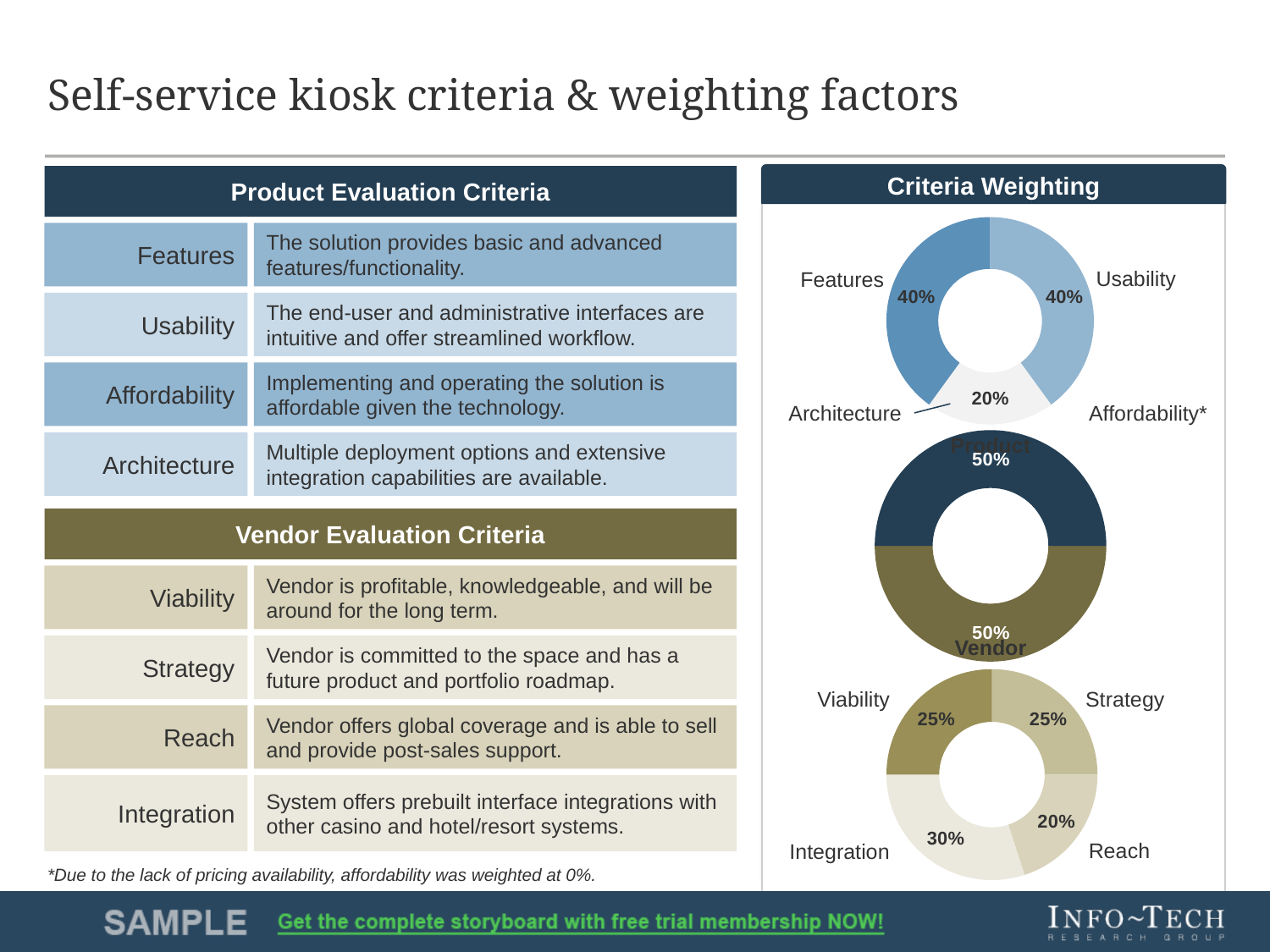
In the bottom donut chart under Criteria Weighting, which criterion has the highest weighting? Integration In the middle donut chart under Criteria Weighting, how many segments are shown? 2 In the bottom donut chart under Criteria Weighting, what is the weighting for Reach? 20% In the top donut chart under Criteria Weighting, which criterion has the lowest non-zero weighting? Architecture In the bottom donut chart under Criteria Weighting, what is the weighting for Integration? 30% In the top donut chart under Criteria Weighting, what is the weighting for Architecture? 20% In the top donut chart under Criteria Weighting, what is the weighting for Features? 40% In the top donut chart under Criteria Weighting, what is the difference between the Usability and Architecture weightings? 20% In the bottom donut chart under Criteria Weighting, which is larger, the weighting for Viability or for Reach? Viability What type of chart is used in the Criteria Weighting section? Donut chart In the middle donut chart under Criteria Weighting, what is the weighting for Vendor? 50% In the bottom donut chart under Criteria Weighting, what is the difference between the Integration and Reach weightings? 10%